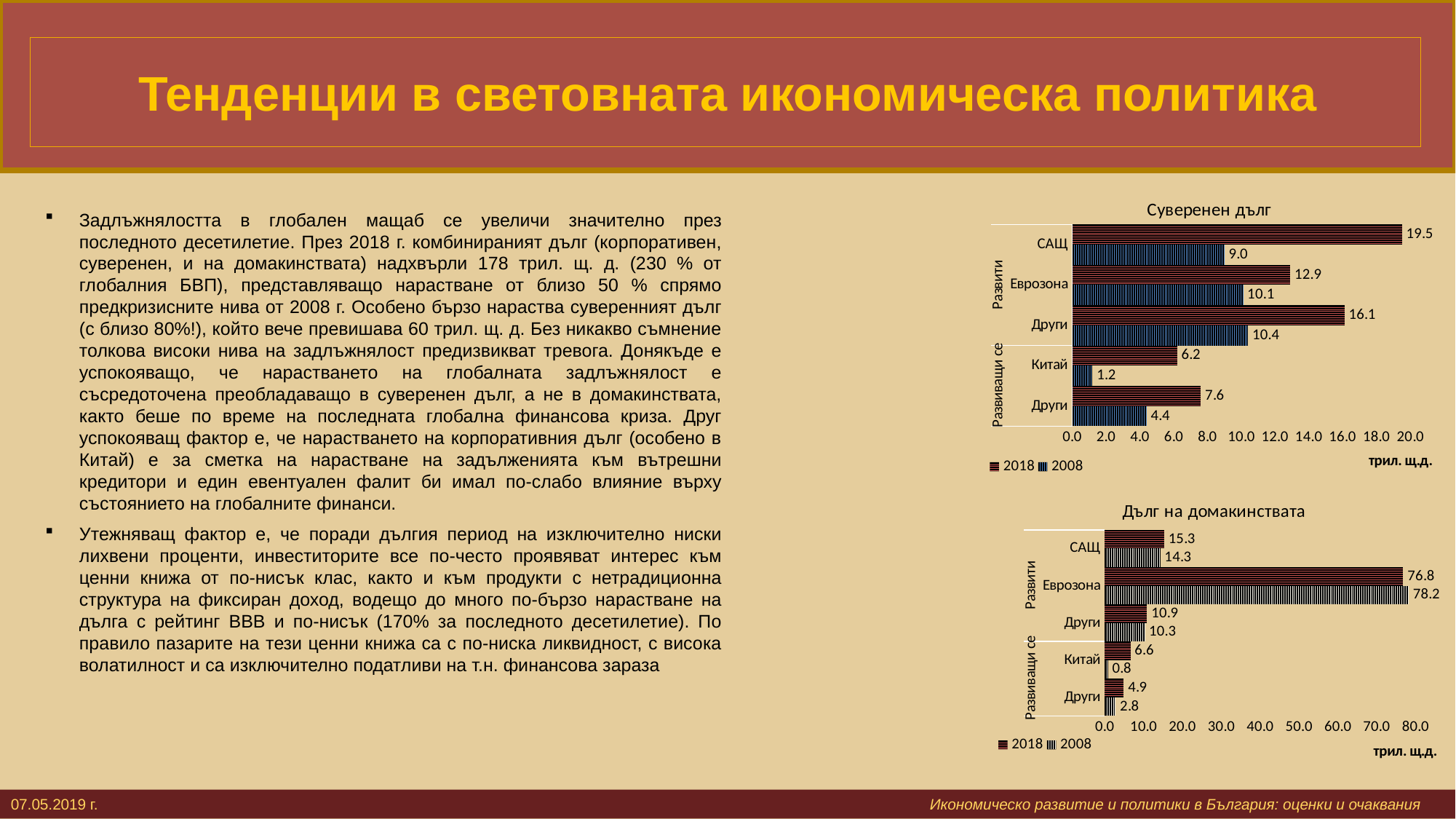
In the 'Суверенен дълг' chart, what is the 2018 value for САЩ? 19.5 In the 'Дълг на домакинствата' chart, is the 2018 value for Еврозона larger or the 2008 value? 2008 In the 'Суверенен дълг' chart, what is the 2018 value for Други in the Развити group? 16.1 In the 'Дълг на домакинствата' chart, what is the difference between the 2018 and 2008 values for Китай? 5.8 In the 'Дълг на домакинствата' chart, how many categories are shown? 5 In the 'Суверенен дълг' chart, which category has the highest 2018 value? САЩ In the 'Дълг на домакинствата' chart, which category has the lowest 2008 value? Китай In the 'Суверенен дълг' chart, what is the difference between the 2018 and 2008 values for САЩ? 10.5 In the 'Суверенен дълг' chart, what is the 2008 value for Китай? 1.2 What type of chart is 'Дълг на домакинствата'? Bar chart In the 'Суверенен дълг' chart, how many series does the legend list? 2 In the 'Дълг на домакинствата' chart, what is the 2008 value for Еврозона? 78.2